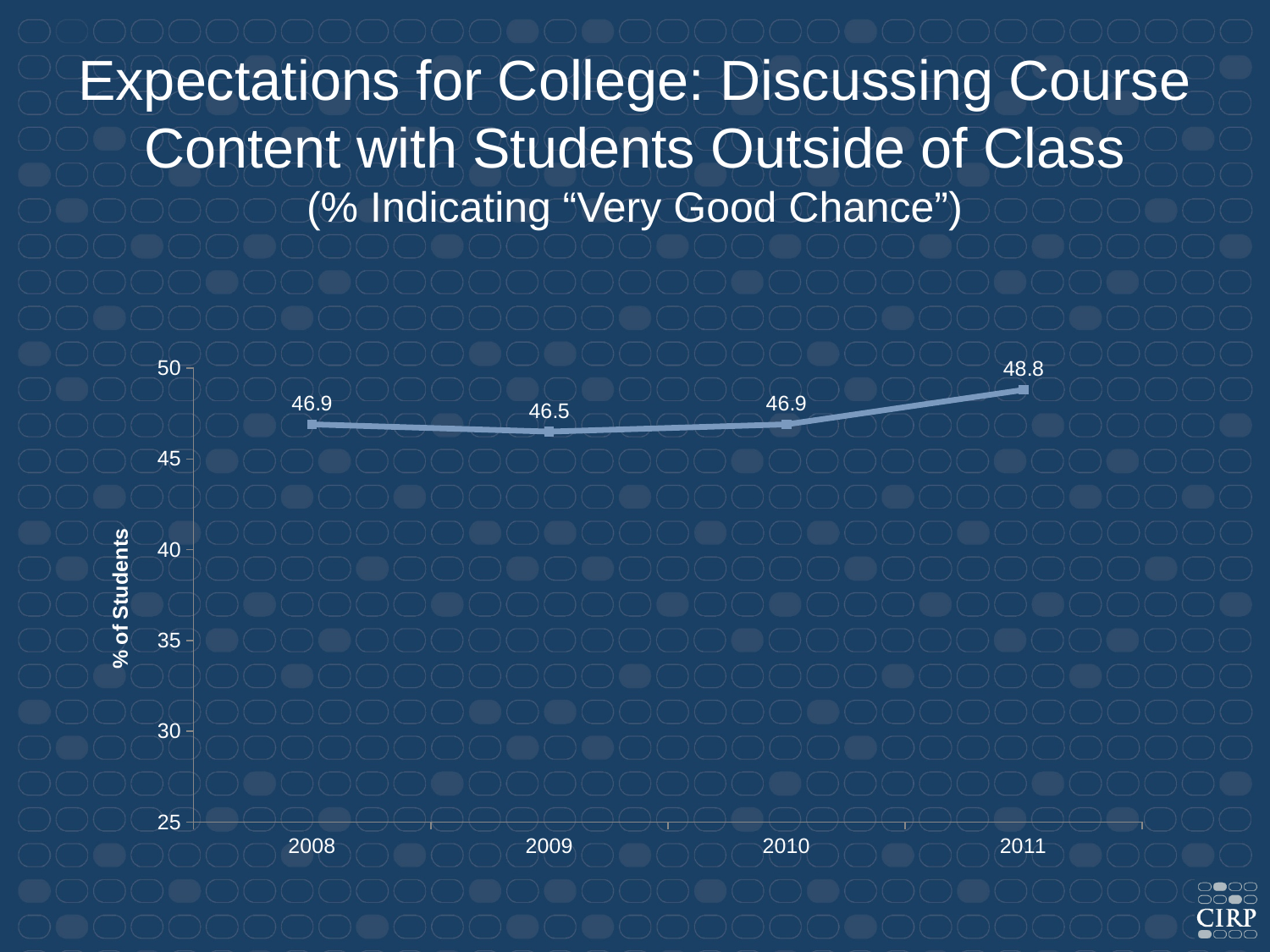
What is the label on the vertical axis? % of Students Which is larger, the value for 2011 or the value for 2009? 2011 Is the value for 2011 greater or less than 50? less What is the value for 2009? 46.5 How many years are plotted on the chart? 4 What is the value for 2008? 46.9 What kind of chart is shown on the slide? line chart What is the difference between the values for 2011 and 2010? 1.9 Which year has the lowest value? 2009 What is the difference between the values for 2008 and 2009? 0.4 What is the value for 2011? 48.8 Which year has the highest value? 2011